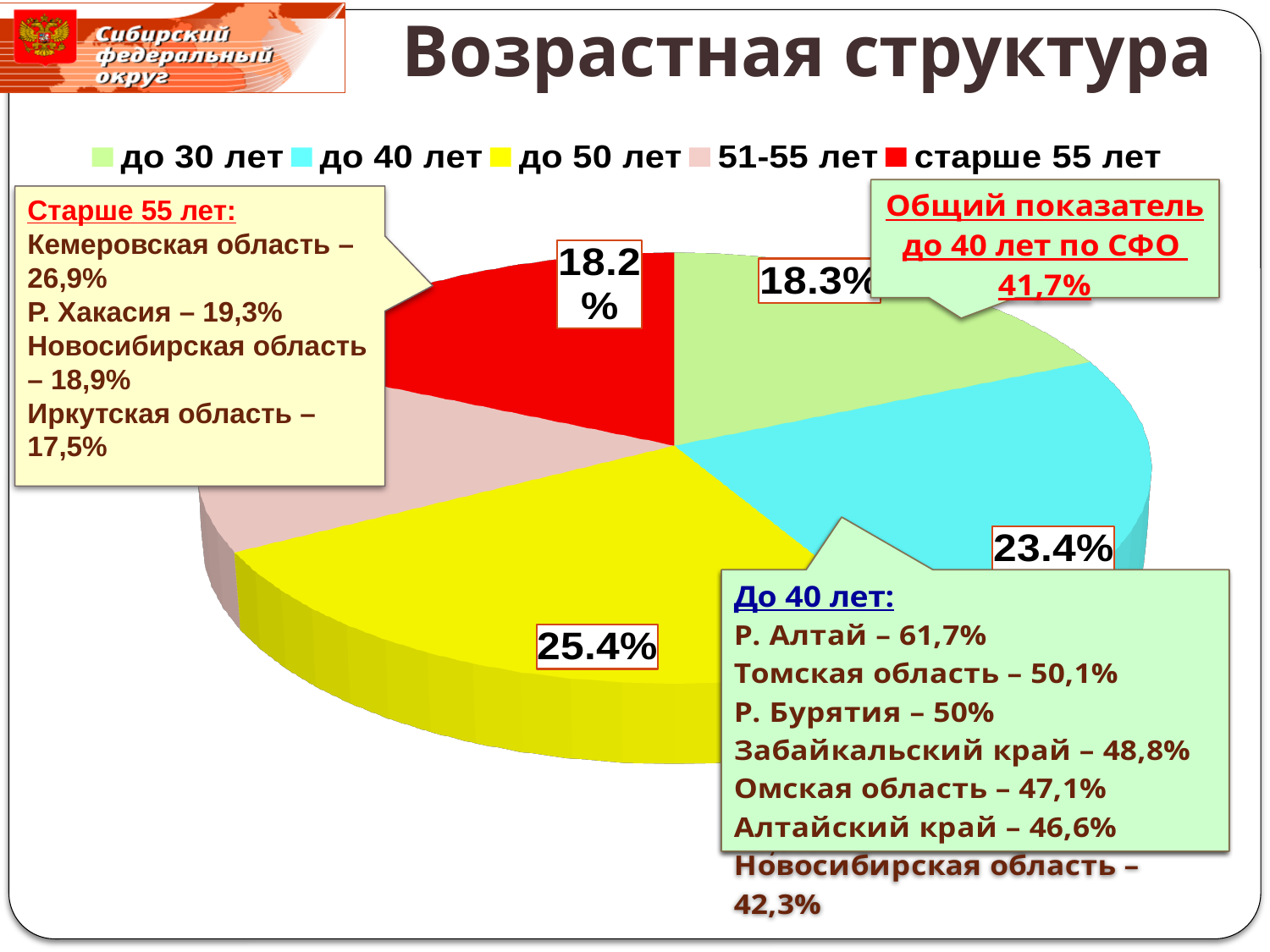
What colour is the 'старше 55 лет' slice in the pie chart? red What is the title of the slide's chart? Возрастная структура Which age group has the largest slice of the pie? до 50 лет What share of the pie does the 'до 40 лет' slice have? 23.4% What share of the pie does the 'до 50 лет' slice have? 25.4% Which is larger, the 'до 50 лет' slice or the 'до 40 лет' slice? до 50 лет How many age groups does the legend list? 5 What share of the pie does the 'старше 55 лет' slice have? 18.2% What kind of chart is shown on the slide? pie chart What share of the pie does the 'до 30 лет' slice have? 18.3% What is the difference in percentage points between the 'до 50 лет' slice and the 'до 40 лет' slice? 2.0 What is the difference in percentage points between the 'до 40 лет' slice and the 'до 30 лет' slice? 5.1